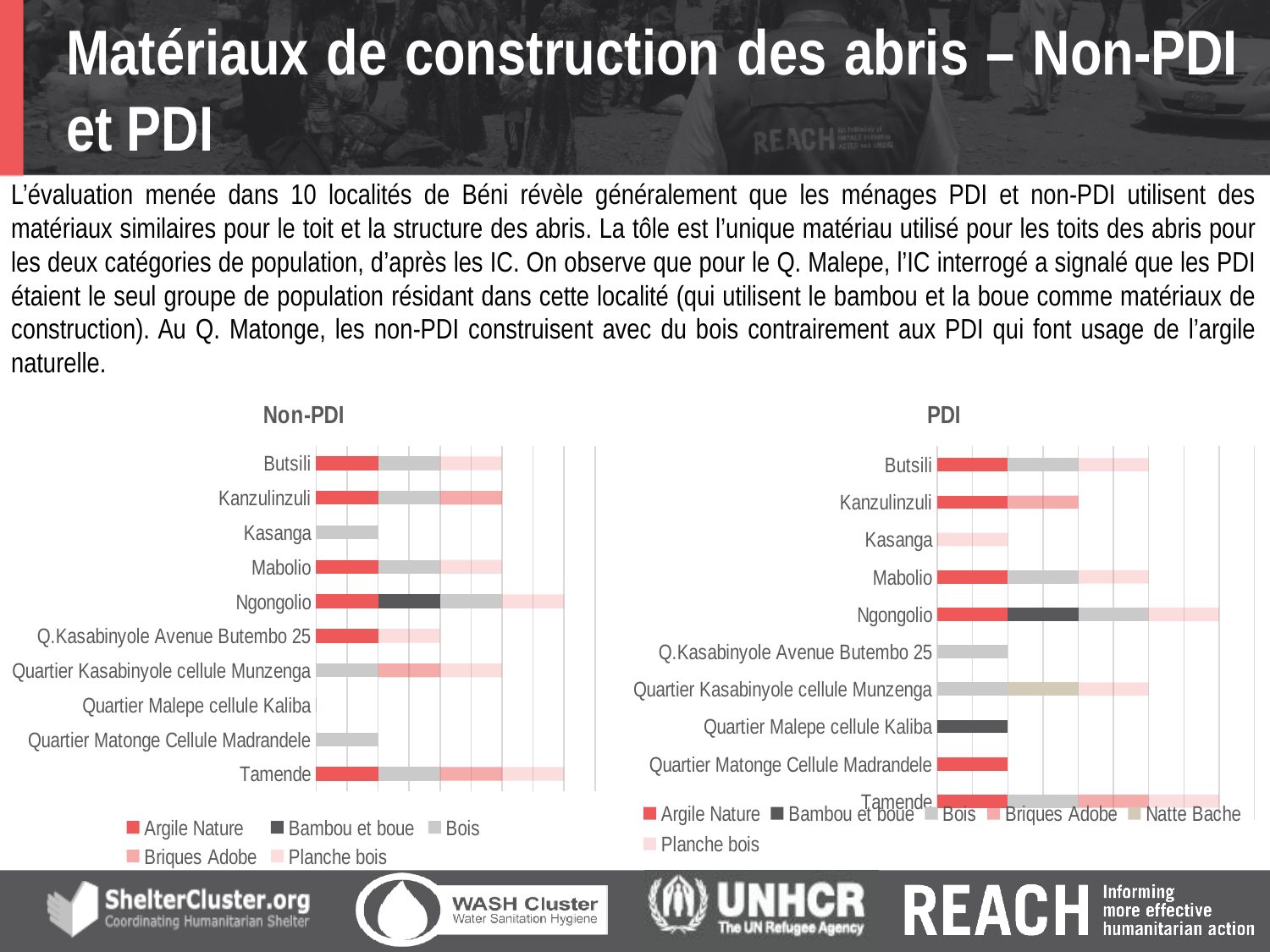
What type of chart is the Non-PDI chart? Bar chart On the Non-PDI chart, which locality has no bar at all? Quartier Malepe cellule Kaliba How many series does the legend of the Non-PDI chart list? 5 How many localities are listed on the PDI chart? 10 On the PDI chart, which single material is shown for Quartier Matonge Cellule Madrandele? Argile Nature On the PDI chart, which single material is shown for Quartier Malepe cellule Kaliba? Bambou et boue How many series does the legend of the PDI chart list? 6 On the Non-PDI chart, which single material is shown for Quartier Matonge Cellule Madrandele? Bois On the Non-PDI chart, which single material is shown for Kasanga? Bois On the Non-PDI chart, which bar is longer, Butsili or Kasanga? Butsili On the PDI chart, which bar is longer, Ngongolio or Kasanga? Ngongolio Which material appears in the legend of the PDI chart but not in the legend of the Non-PDI chart? Natte Bache